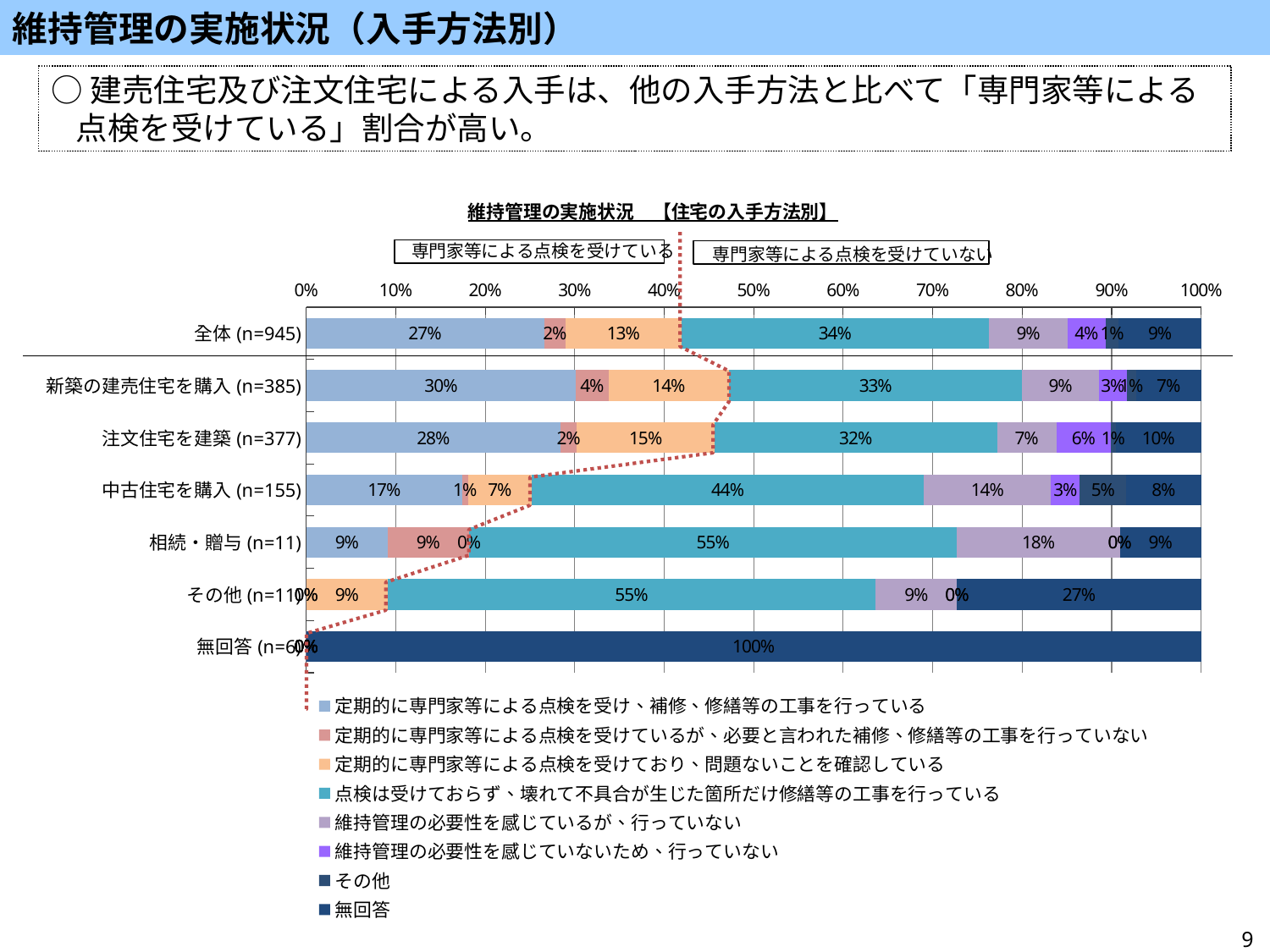
Which category has the highest value for 「定期的に専門家等による点検を受け、補修、修繕等の工事を行っている」? 新築の建売住宅を購入 (n=385) What is the value of 「定期的に専門家等による点検を受け、補修、修繕等の工事を行っている」 for 全体 (n=945)? 27% How many series does the legend list? 8 What is the value of 「維持管理の必要性を感じているが、行っていない」 for 相続・贈与 (n=11)? 18% What is the value of 「点検は受けておらず、壊れて不具合が生じた箇所だけ修繕等の工事を行っている」 for 中古住宅を購入 (n=155)? 44% What is the title of the chart? 維持管理の実施状況 【住宅の入手方法別】 What is the value of 「定期的に専門家等による点検を受けており、問題ないことを確認している」 for 注文住宅を建築 (n=377)? 15% What is the difference between the 「定期的に専門家等による点検を受け、補修、修繕等の工事を行っている」 values for 新築の建売住宅を購入 (n=385) and 全体 (n=945)? 3 percentage points What is the value of 「無回答」 for 無回答 (n=6)? 100% What kind of chart is shown on the slide? Stacked bar chart Which is larger: the 「点検は受けておらず、壊れて不具合が生じた箇所だけ修繕等の工事を行っている」 value for 全体 (n=945) or for 中古住宅を購入 (n=155)? 中古住宅を購入 (n=155) How many categories (rows) are plotted in the chart? 7